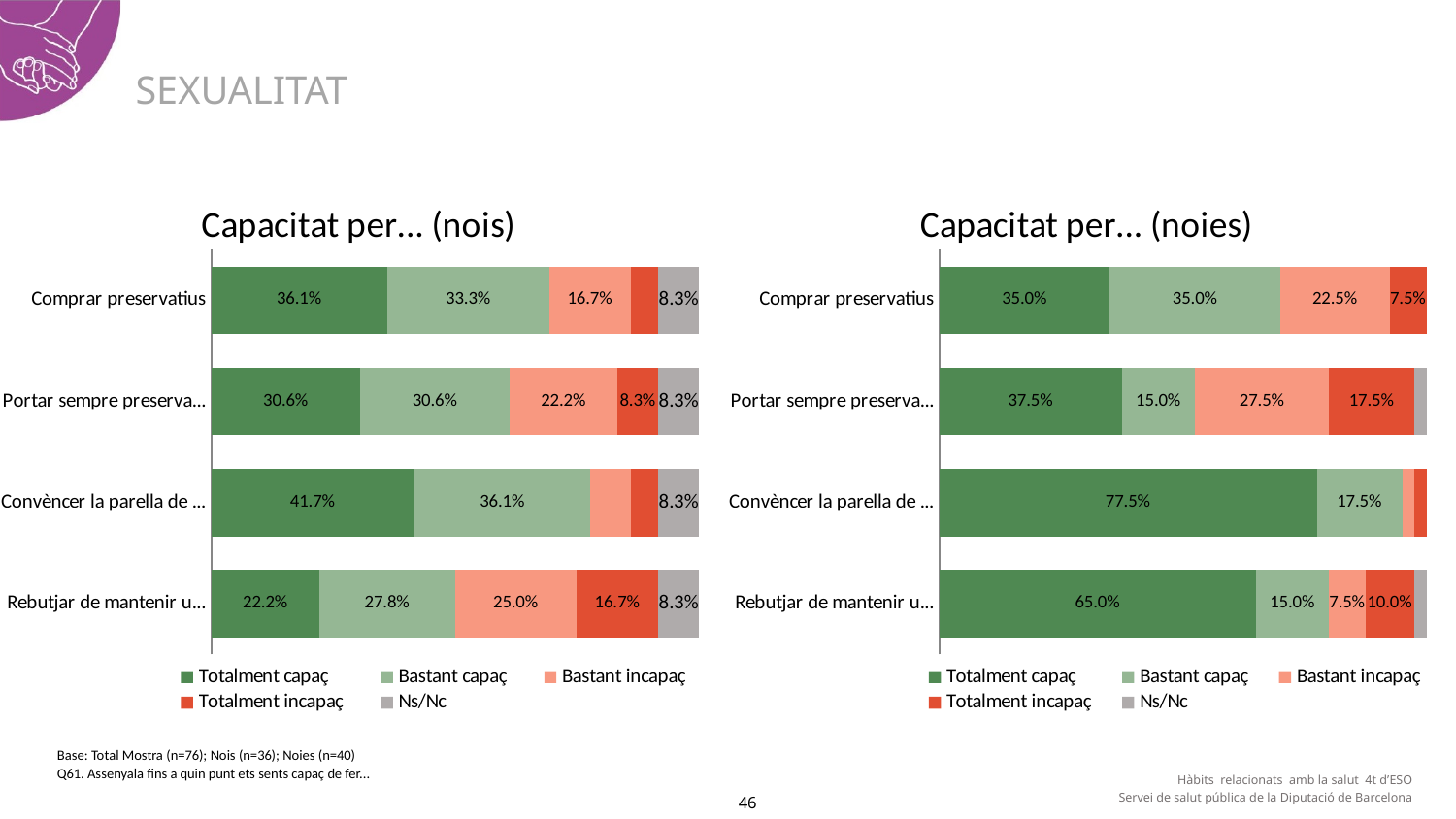
How many categories are shown in the 'Capacitat per… (noies)' chart? 4 What type of chart is 'Capacitat per… (nois)'? Stacked bar chart In the 'Capacitat per… (noies)' chart, which legend entry is shown in grey? Ns/Nc In the 'Capacitat per… (nois)' chart, what is the 'Totalment incapaç' value for 'Rebutjar de mantenir u…'? 16.7% In the 'Capacitat per… (noies)' chart, which category has the highest 'Totalment capaç' value? Convèncer la parella de … In the 'Capacitat per… (noies)' chart, what is the 'Totalment capaç' value for 'Convèncer la parella de …'? 77.5% In the 'Capacitat per… (nois)' chart, which category has the lowest 'Totalment capaç' value? Rebutjar de mantenir u… In the 'Capacitat per… (noies)' chart, what is the 'Bastant incapaç' value for 'Portar sempre preserva…'? 27.5% How many series does the legend of the 'Capacitat per… (nois)' chart list? 5 Which is larger: the 'Totalment capaç' value for 'Rebutjar de mantenir u…' in the nois chart or in the noies chart? Noies chart In the 'Capacitat per… (nois)' chart, what is the difference between the 'Totalment capaç' values for 'Convèncer la parella de …' and 'Rebutjar de mantenir u…'? 19.5% In the 'Capacitat per… (nois)' chart, what is the 'Totalment capaç' value for 'Comprar preservatius'? 36.1%